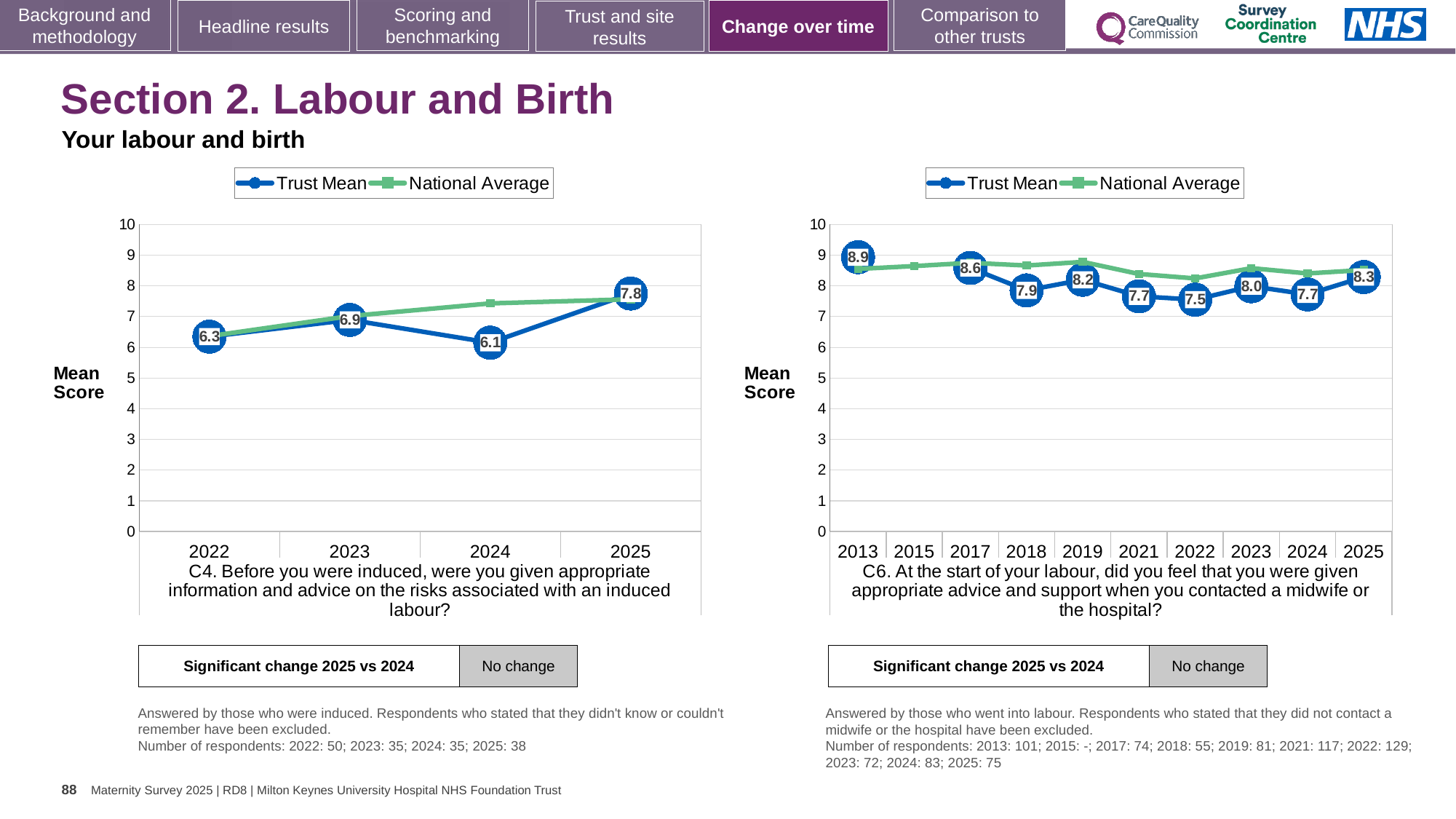
In the C6 chart on the right, what is the Trust Mean for 2013? 8.9 In the C6 chart on the right, what is the Trust Mean for 2022? 7.5 What kind of chart is the C6 chart on the right? Line chart In the C6 chart on the right, which year has the lowest Trust Mean? 2022 In the C4 chart on the left, which year has the highest Trust Mean? 2025 In the C6 chart on the right, is the Trust Mean for 2025 or 2024 larger? 2025 In the C6 chart on the right, how many years are shown on the x axis? 10 In the C4 chart on the left, what is the difference between the Trust Mean for 2025 and 2024? 1.7 In the C4 chart on the left, how many series does the legend list? 2 In the C4 chart on the left, what is the Trust Mean for 2024? 6.1 In the C4 chart on the left, which year has the lowest Trust Mean? 2024 In the C4 chart on the left, what is the Trust Mean for 2025? 7.8